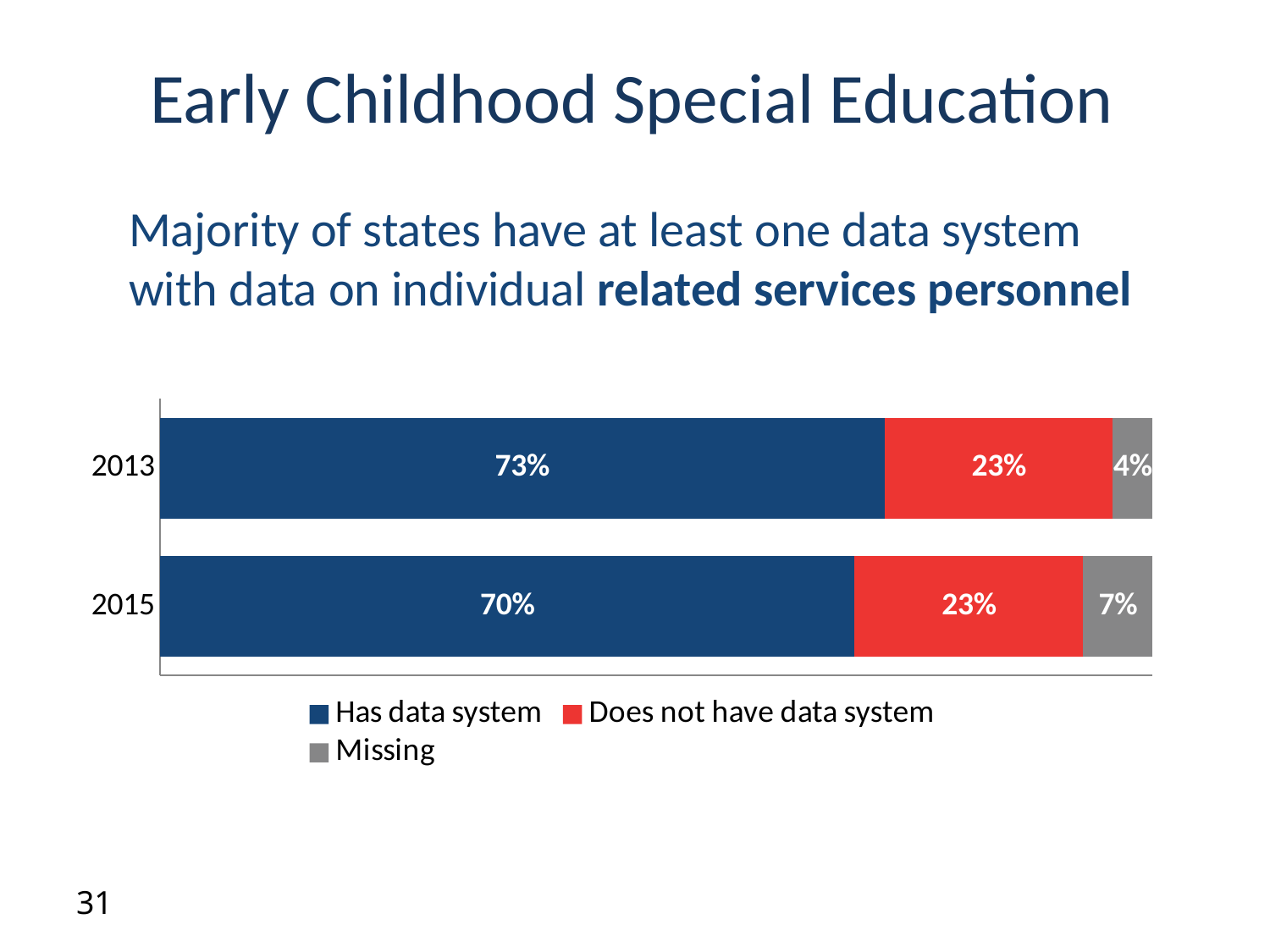
What is the difference between the 'Has data system' values for 2013 and 2015? 3% How many years are shown on the chart? 2 What is the total of the 2015 stacked bar? 100% Which year has the higher 'Has data system' percentage? 2013 What percentage of states had a data system in 2013? 73% What is the 'Missing' value for 2013? 4% What kind of chart is shown on the slide? Stacked bar chart How many series does the legend list? 3 What percentage of states had a data system in 2015? 70% Which year has the higher 'Missing' percentage? 2015 What is the value for 'Does not have data system' in 2015? 23% What is the 'Missing' value for 2015? 7%